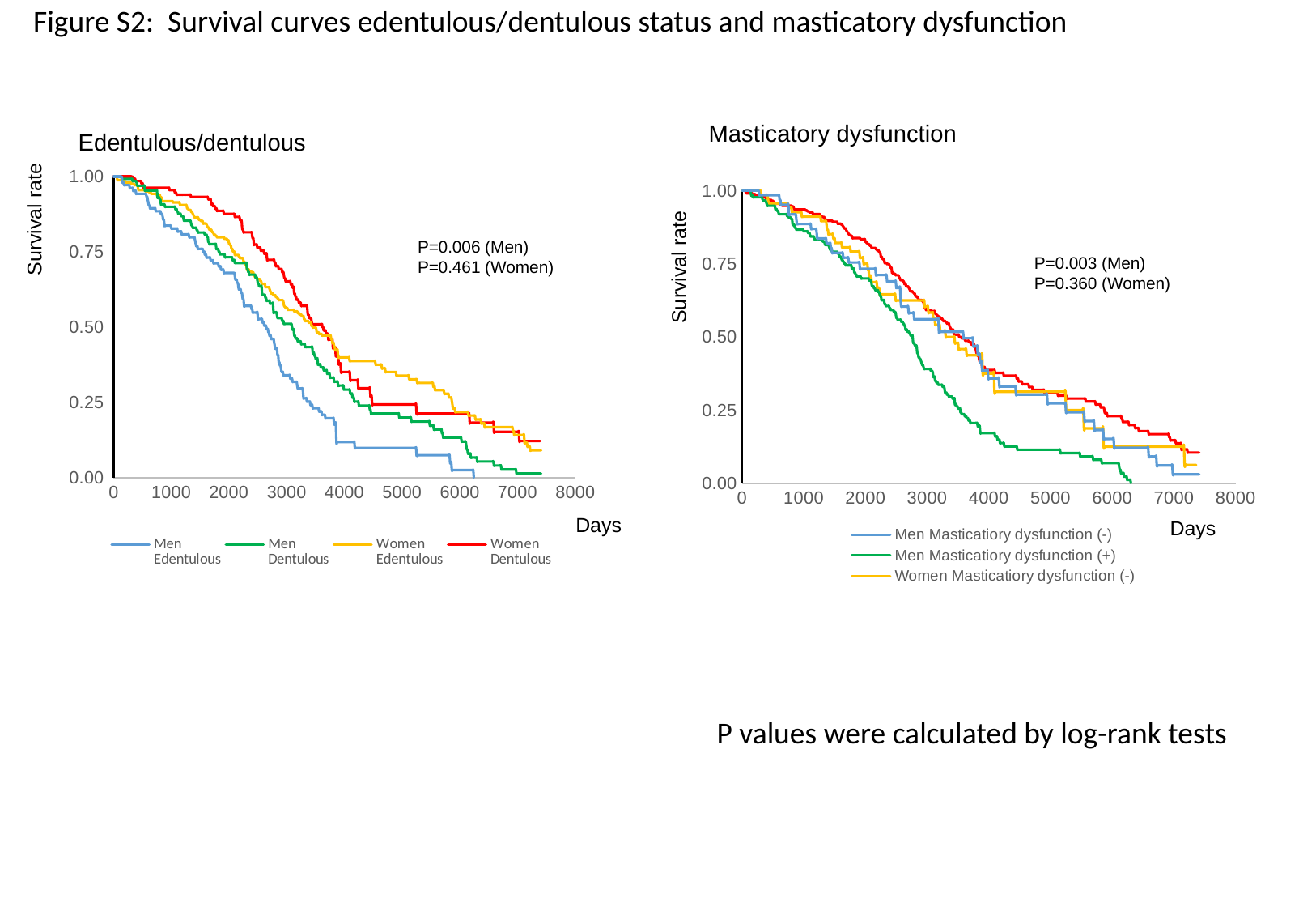
In the Edentulous/dentulous chart, is the survival rate for Women Edentulous at 4000 days greater or less than 0.25? greater In the Masticatory dysfunction chart, is the survival rate for Men Masticatiory dysfunction (+) at 4000 days greater or less than 0.25? less How many series does the legend of the Edentulous/dentulous chart list? 4 What kind of chart is the Edentulous/dentulous chart on the left? Line chart In the Masticatory dysfunction chart, is the survival rate for Women Masticatiory dysfunction (-) at 2000 days greater or less than 0.50? greater In the Masticatory dysfunction chart, at 3000 days, which series has the higher survival rate: Men Masticatiory dysfunction (-) or Men Masticatiory dysfunction (+)? Men Masticatiory dysfunction (-) In the Edentulous/dentulous chart, do the survival rate curves rise or fall as days increase? Fall In the Edentulous/dentulous chart, what P value is shown for men? P=0.006 In the Edentulous/dentulous chart, at 3000 days, which series has the higher survival rate: Men Edentulous or Women Dentulous? Women Dentulous In the Masticatory dysfunction chart, what P value is shown for women? P=0.360 How many series does the legend of the Masticatory dysfunction chart list? 3